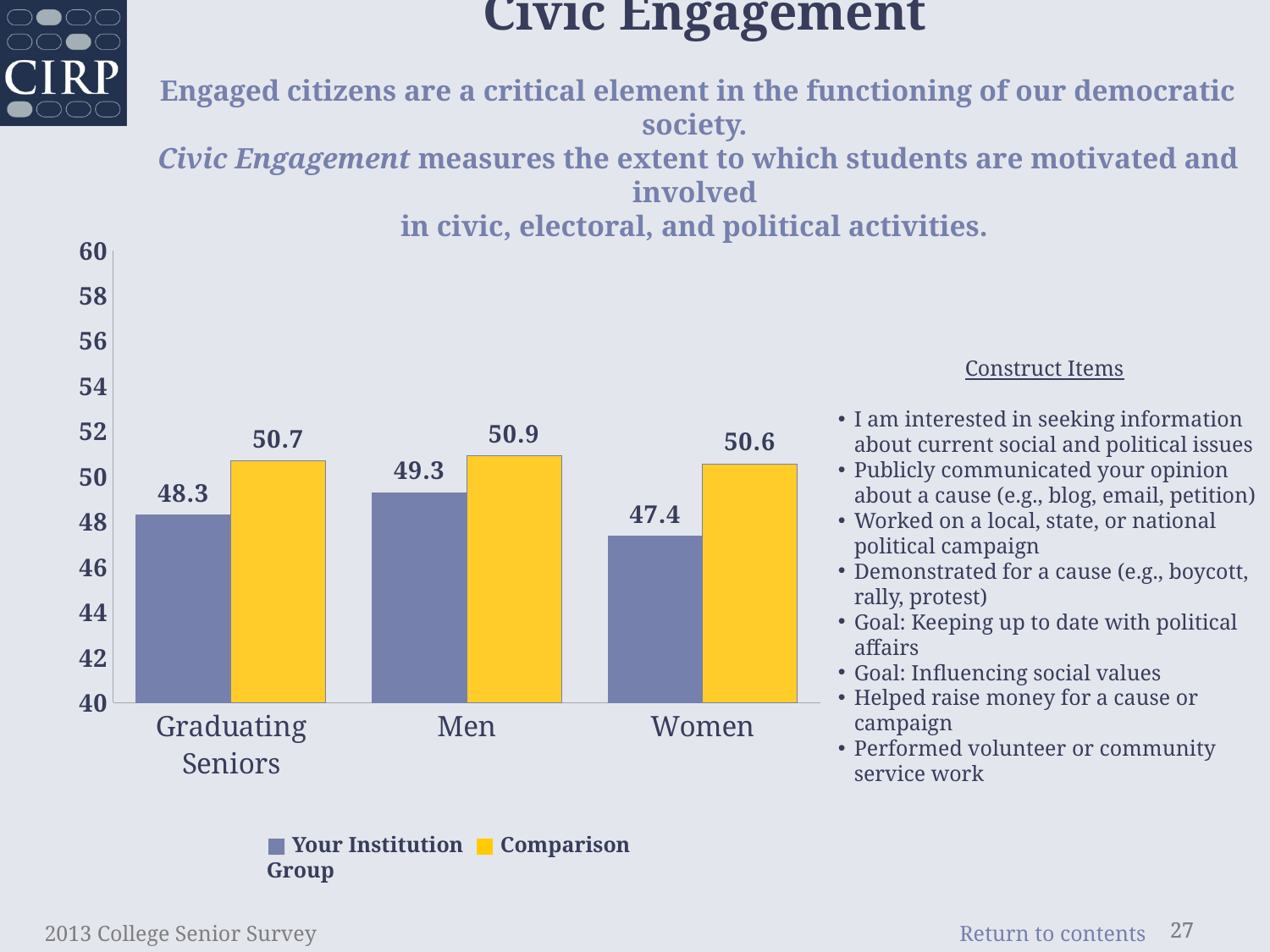
What is the Your Institution value for Graduating Seniors? 48.3 Which category has the lowest Your Institution value? Women Which category has the highest Comparison Group value? Men How many categories are shown on the x axis? 3 Which is larger for Graduating Seniors: Your Institution or Comparison Group? Comparison Group What is the Your Institution value for Women? 47.4 What is the difference between the Comparison Group and Your Institution values for Women? 3.2 Is the Your Institution value for Men greater or less than 50? less What is the difference between the Your Institution values for Men and Women? 1.9 What kind of chart is shown on the slide? bar chart How many series does the legend list? 2 What is the Comparison Group value for Men? 50.9